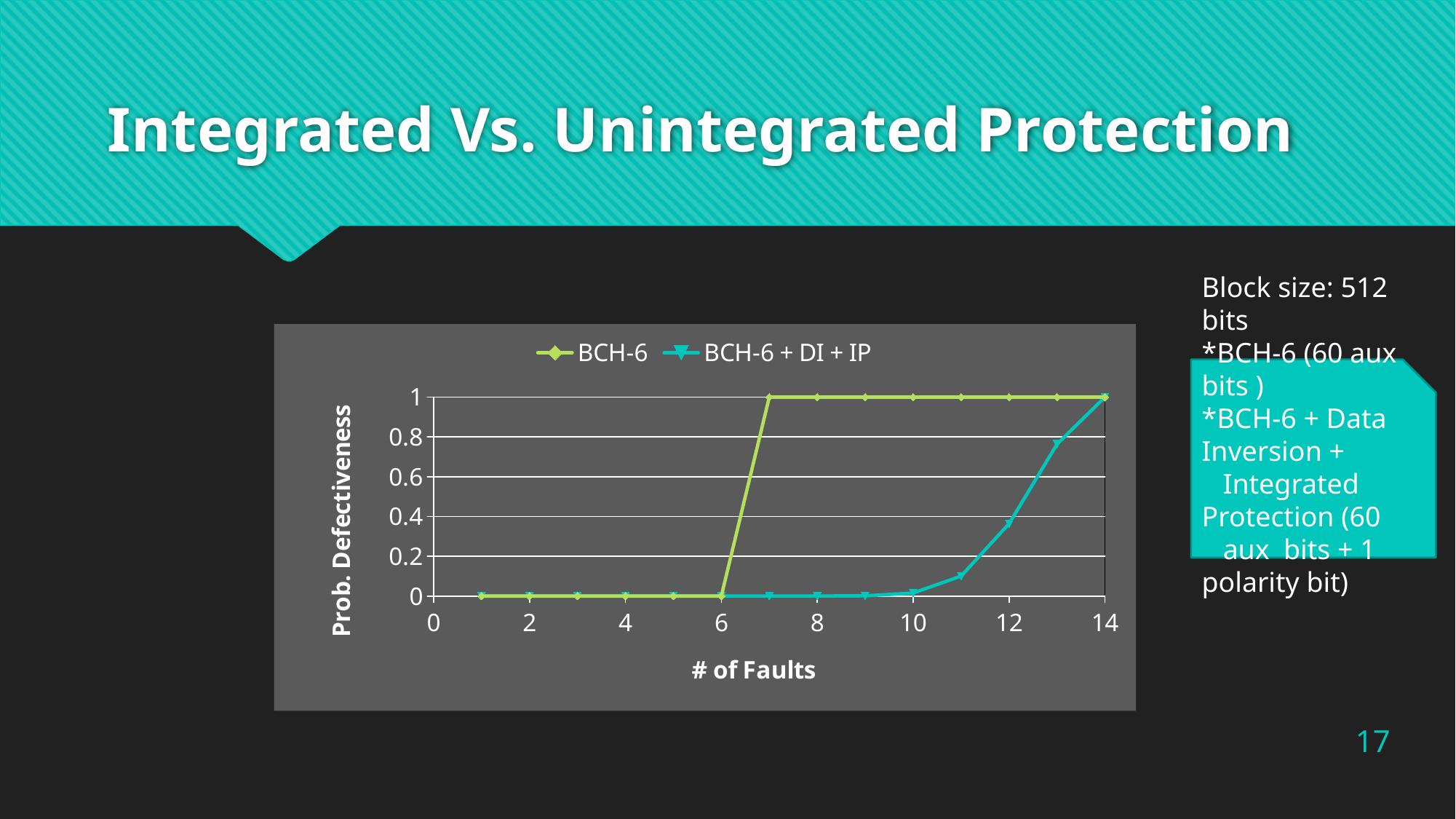
What is the Prob. Defectiveness for BCH-6 at 6 faults? 0 Is the value for BCH-6 + DI + IP at 13 faults greater or less than 0.6? greater What kind of chart is shown on the slide? line chart What is the Prob. Defectiveness for BCH-6 + DI + IP at 14 faults? 1 What is the Prob. Defectiveness for BCH-6 + DI + IP at 8 faults? 0 Does the BCH-6 + DI + IP series rise or fall as the number of faults increases? rise At 10 faults, which series has the higher Prob. Defectiveness? BCH-6 What is the title of the x axis of the chart? # of Faults Is the value for BCH-6 + DI + IP at 12 faults greater or less than 0.6? less What is the Prob. Defectiveness for BCH-6 at 7 faults? 1 How many series does the chart legend list? 2 What are the two series named in the chart legend? BCH-6 and BCH-6 + DI + IP